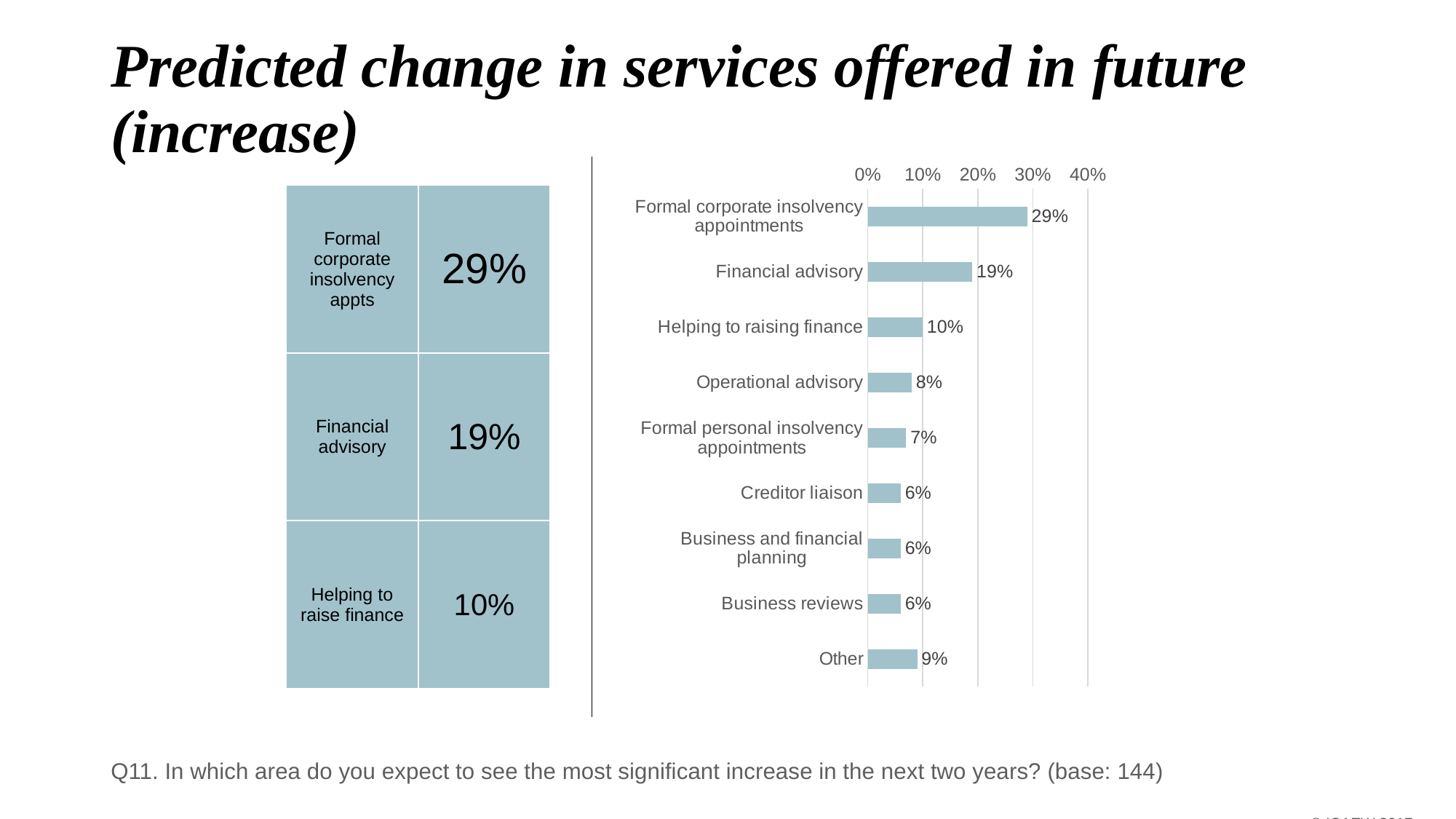
How many categories are shown in the chart? 9 Is the value for Financial advisory greater or less than 20%? less What is the value for Formal personal insolvency appointments? 7% What is the value for Formal corporate insolvency appointments? 29% What is the value for Financial advisory? 19% What is the value for Operational advisory? 8% Which category has the highest value? Formal corporate insolvency appointments What is the difference between Formal corporate insolvency appointments and Financial advisory? 10% What is the value for Other? 9% What kind of chart is shown on the slide? bar chart What is the highest value shown on the x axis? 40% Which is larger, Helping to raising finance or Operational advisory? Helping to raising finance